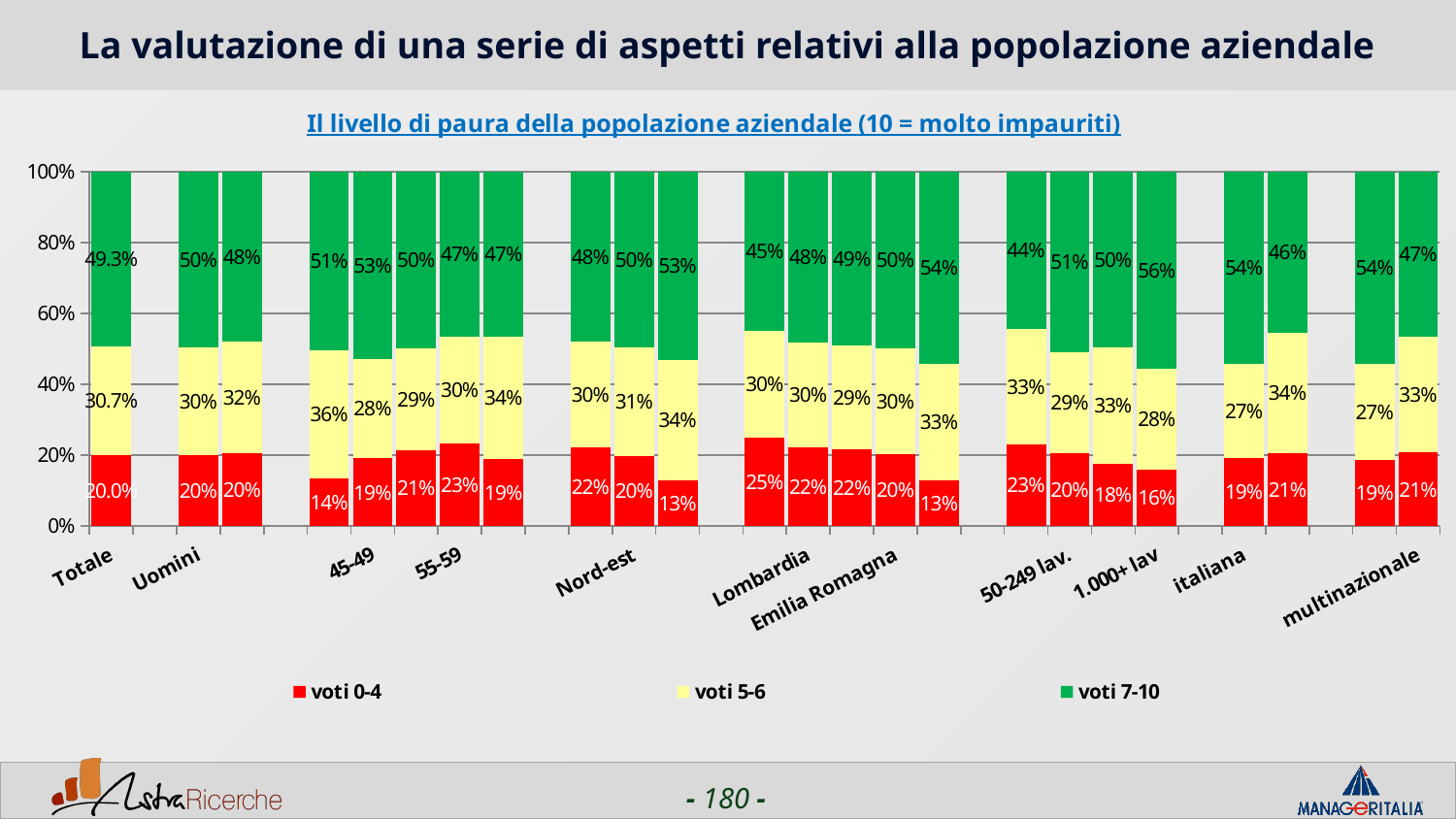
What are the three legend entries of the chart? voti 0-4, voti 5-6, voti 7-10 What is the value of the "voti 5-6" series for the "multinazionale" category? 33% What colour represents the "voti 7-10" series? Green Which has a higher "voti 0-4" value, "Lombardia" or "Emilia Romagna"? Lombardia What is the value of the "voti 7-10" series for the "Totale" category? 49.3% What kind of chart is shown on the slide? Stacked bar chart What is the difference between the "voti 0-4" values for "55-59" and "1.000+ lav"? 7 percentage points How many series does the legend list? 3 What is the value of the "voti 5-6" series for the "Nord-est" category? 31% What is the value of the "voti 0-4" series for the "55-59" category? 23% What is the value of the "voti 7-10" series for the "1.000+ lav" category? 56% Which has a higher "voti 7-10" value, "italiana" or "multinazionale"? Neither; both are 54%